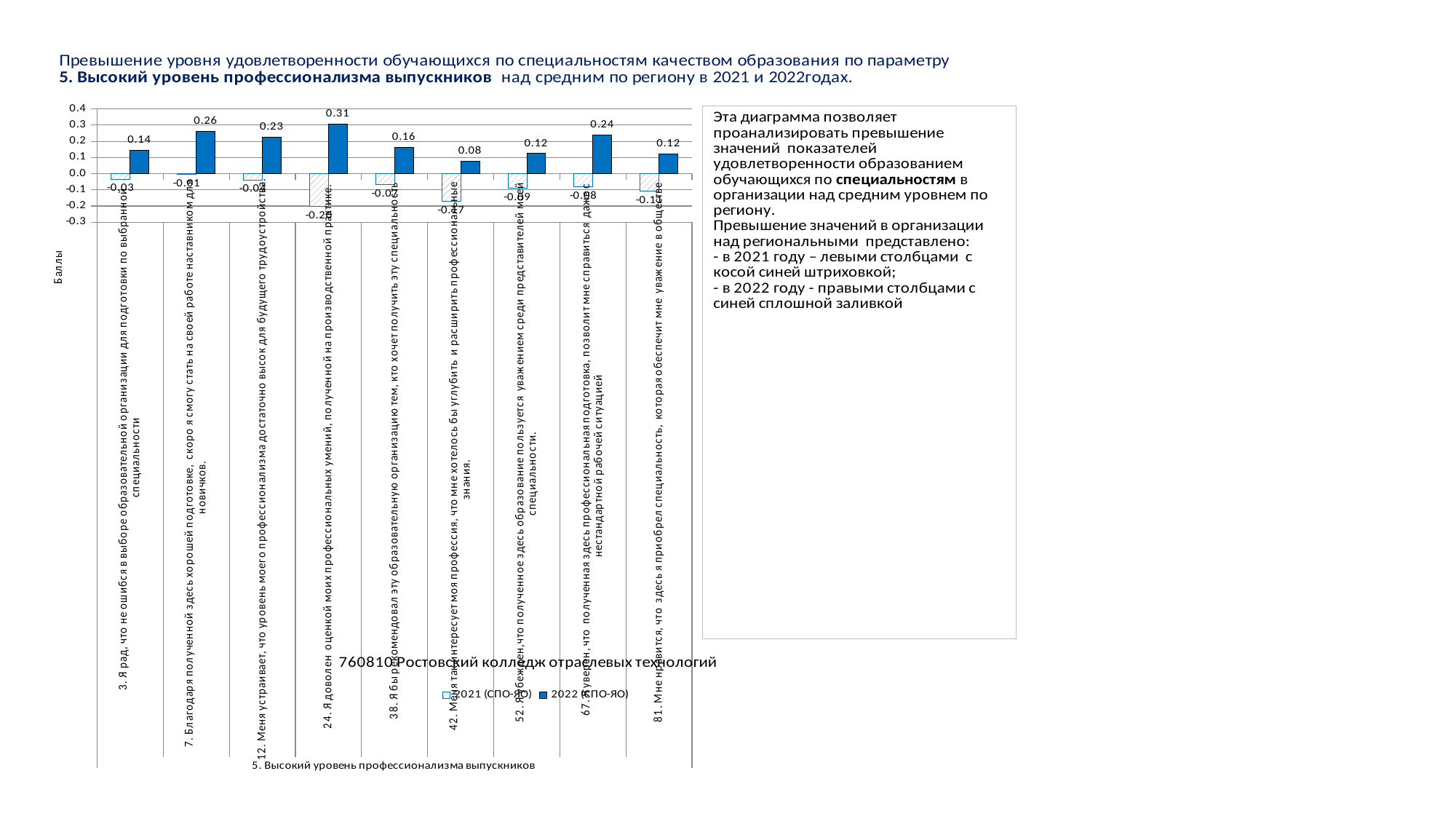
What is the 2022 (СПО-ЯО) value for statement 7 (Благодаря полученной здесь хорошей подготовке...)? 0.26 How many categories (statements) are plotted on the x axis? 9 What is the 2021 (СПО-ЯО) value for statement 3 (Я рад, что не ошибся в выборе образовательной организации...)? -0.03 What kind of chart is shown on the slide? bar chart How many series does the legend list? 2 What is the 2022 (СПО-ЯО) value for statement 24 (Я доволен оценкой моих профессиональных умений...)? 0.31 Which statement has the lowest 2022 (СПО-ЯО) value? 42. Меня так интересует моя профессия, что мне хотелось бы углубить и расширить профессиональные знания What is the difference between the 2022 values for statement 24 and statement 42? 0.23 Which has the larger 2022 (СПО-ЯО) value: statement 7 or statement 12? statement 7 Is the 2021 (СПО-ЯО) value for statement 42 greater or less than -0.1? less Which statement has the highest 2022 (СПО-ЯО) value? 24. Я доволен оценкой моих профессиональных умений, полученной на производственной практике What is the 2022 (СПО-ЯО) value for statement 67 (Уверен, что полученная здесь профессиональная подготовка...)? 0.24